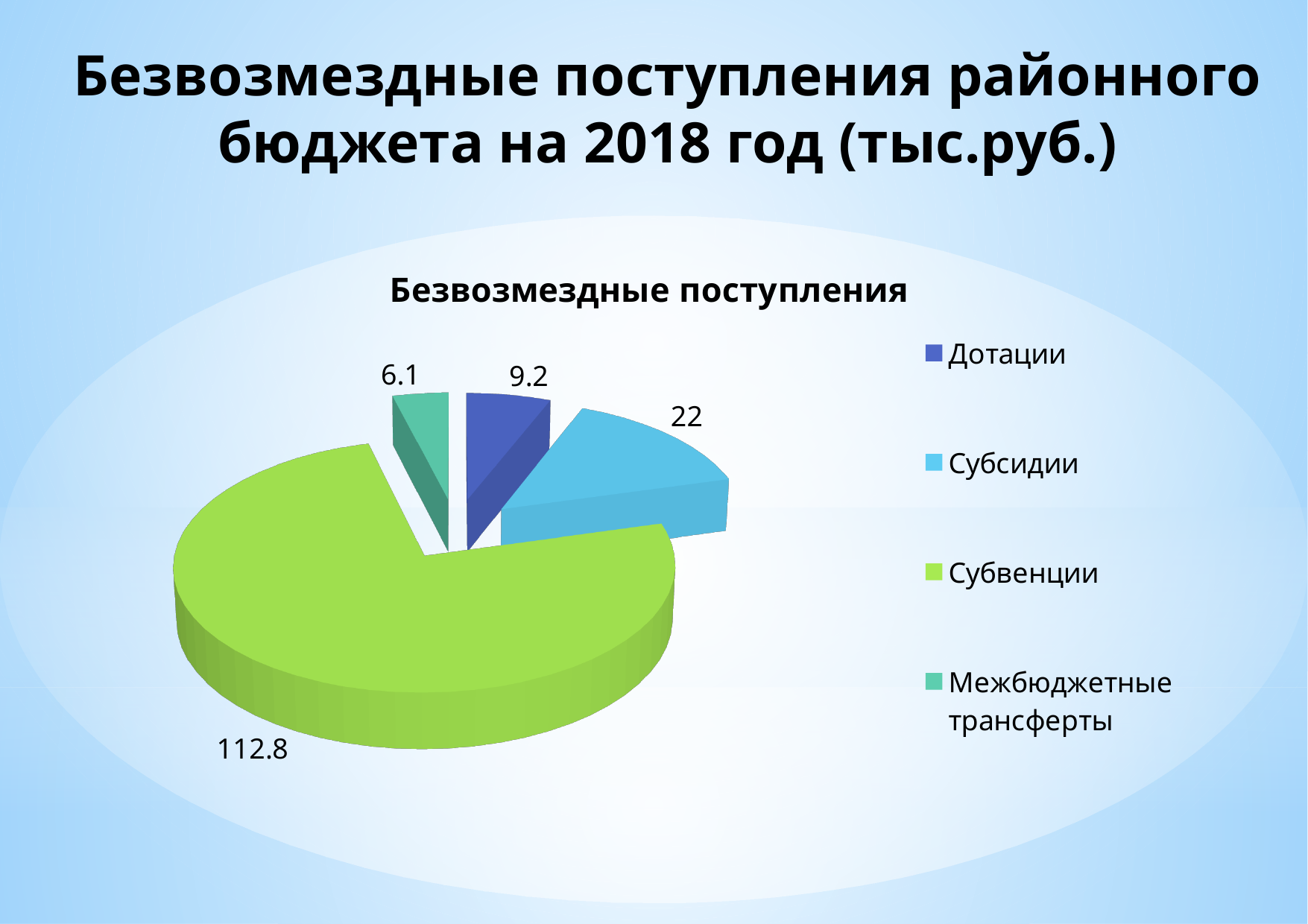
What is the value for Субсидии in the pie chart? 22 Which category has the largest slice in the pie chart? Субвенции Which is larger, the value for Субсидии or the value for Дотации? Субсидии What kind of chart is shown on the slide? Pie chart What is the value for Дотации in the pie chart? 9.2 What is the difference between the values for Субвенции and Субсидии? 90.8 What is the difference between the values for Дотации and Межбюджетные трансферты? 3.1 What is the title of the chart? Безвозмездные поступления What is the value for Межбюджетные трансферты in the pie chart? 6.1 How many categories does the pie chart show? 4 What is the value for Субвенции in the pie chart? 112.8 Which category has the smallest slice in the pie chart? Межбюджетные трансферты